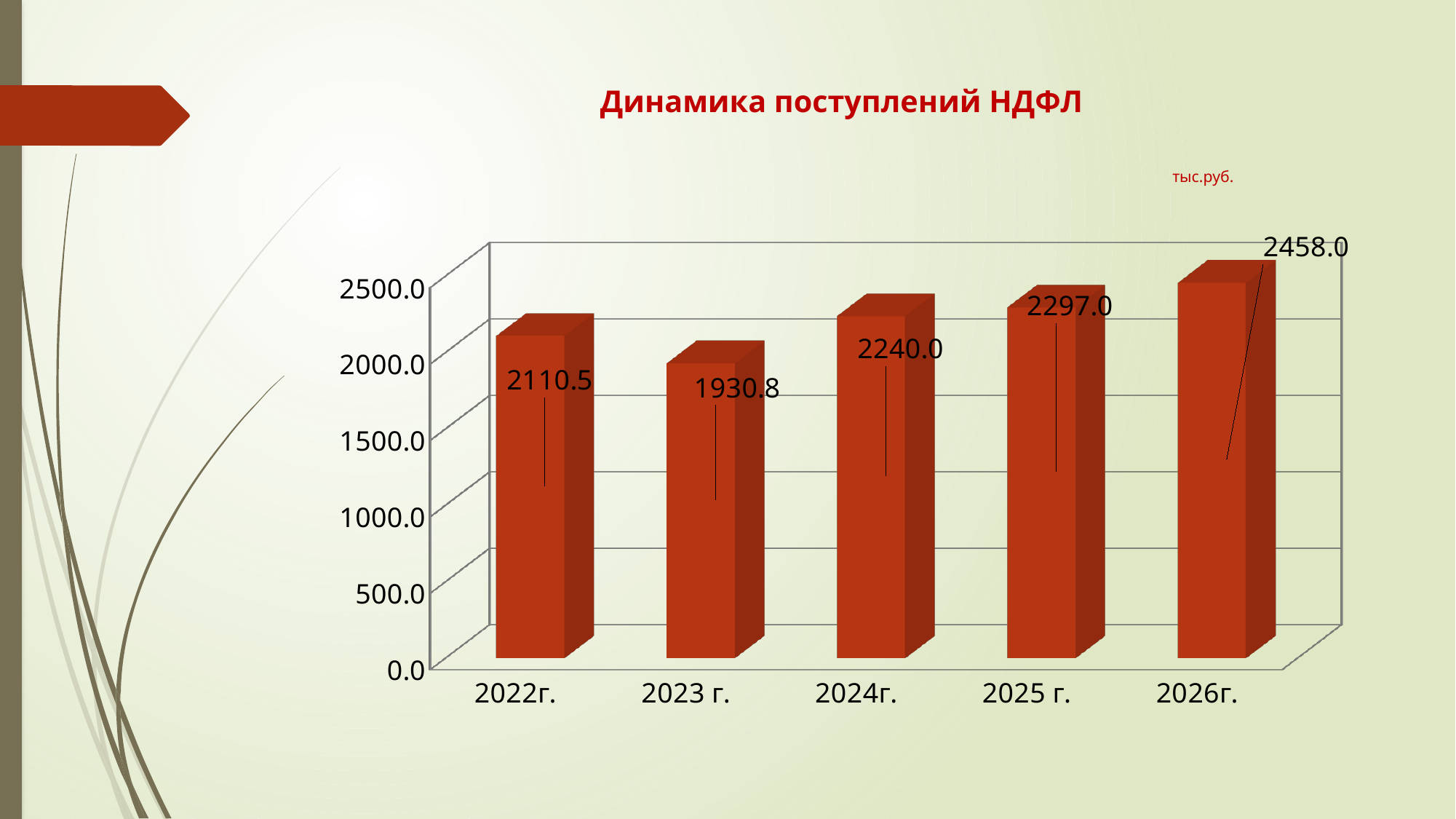
How many years are shown on the chart? 5 What is the value for 2022г.? 2110.5 What is the value for 2023 г.? 1930.8 Which is larger, the value for 2024г. or the value for 2025 г.? 2025 г. What is the value for 2026г.? 2458.0 What is the difference between the values for 2022г. and 2023 г.? 179.7 What is the difference between the values for 2026г. and 2025 г.? 161.0 What is the title of the chart? Динамика поступлений НДФЛ Is the value for 2023 г. greater or less than 2000.0? less Which year has the lowest value? 2023 г. Which year has the highest value? 2026г. What kind of chart is shown on the slide? bar chart